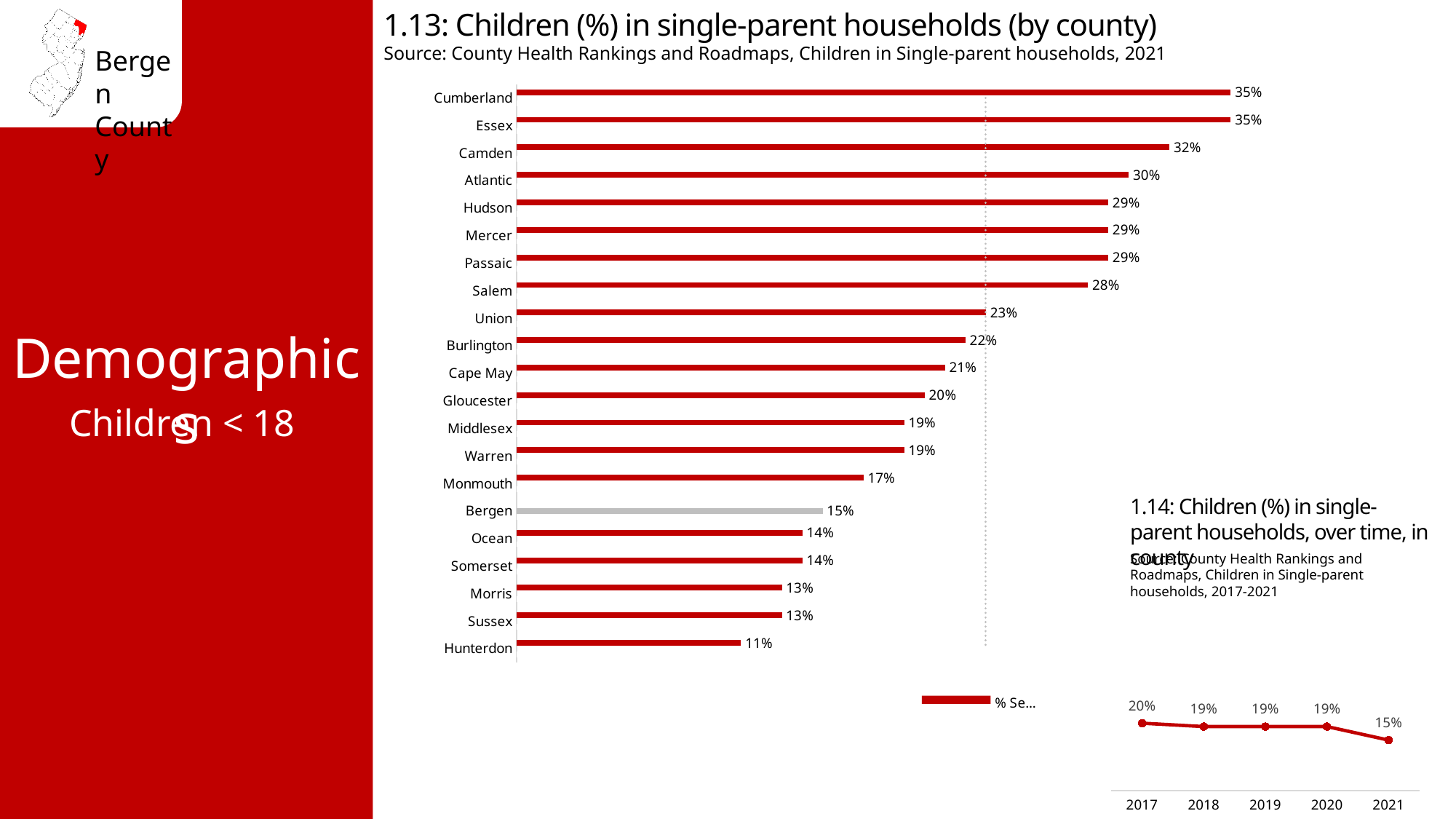
What kind of chart is chart 1.13 (Children (%) in single-parent households by county)? Bar chart In chart 1.13 (by county), what is the value for Camden? 32% In chart 1.14 (over time), do the values rise or fall from 2017 to 2021? Fall In chart 1.13 (by county), which has a higher value, Atlantic or Salem? Atlantic In chart 1.14 (over time), what is the value for 2021? 15% In chart 1.13 (by county), what is the value for Monmouth? 17% In chart 1.14 (Children (%) in single-parent households over time), what is the value for 2017? 20% In chart 1.13 (by county), what is the difference between the values for Cumberland and Bergen? 20% In chart 1.13 (by county), which bar is coloured grey instead of red? Bergen In chart 1.13 (Children (%) in single-parent households by county), what is the value for Bergen? 15% In chart 1.13 (by county), how many counties are shown? 21 In chart 1.13 (by county), which county has the lowest percentage of children in single-parent households? Hunterdon